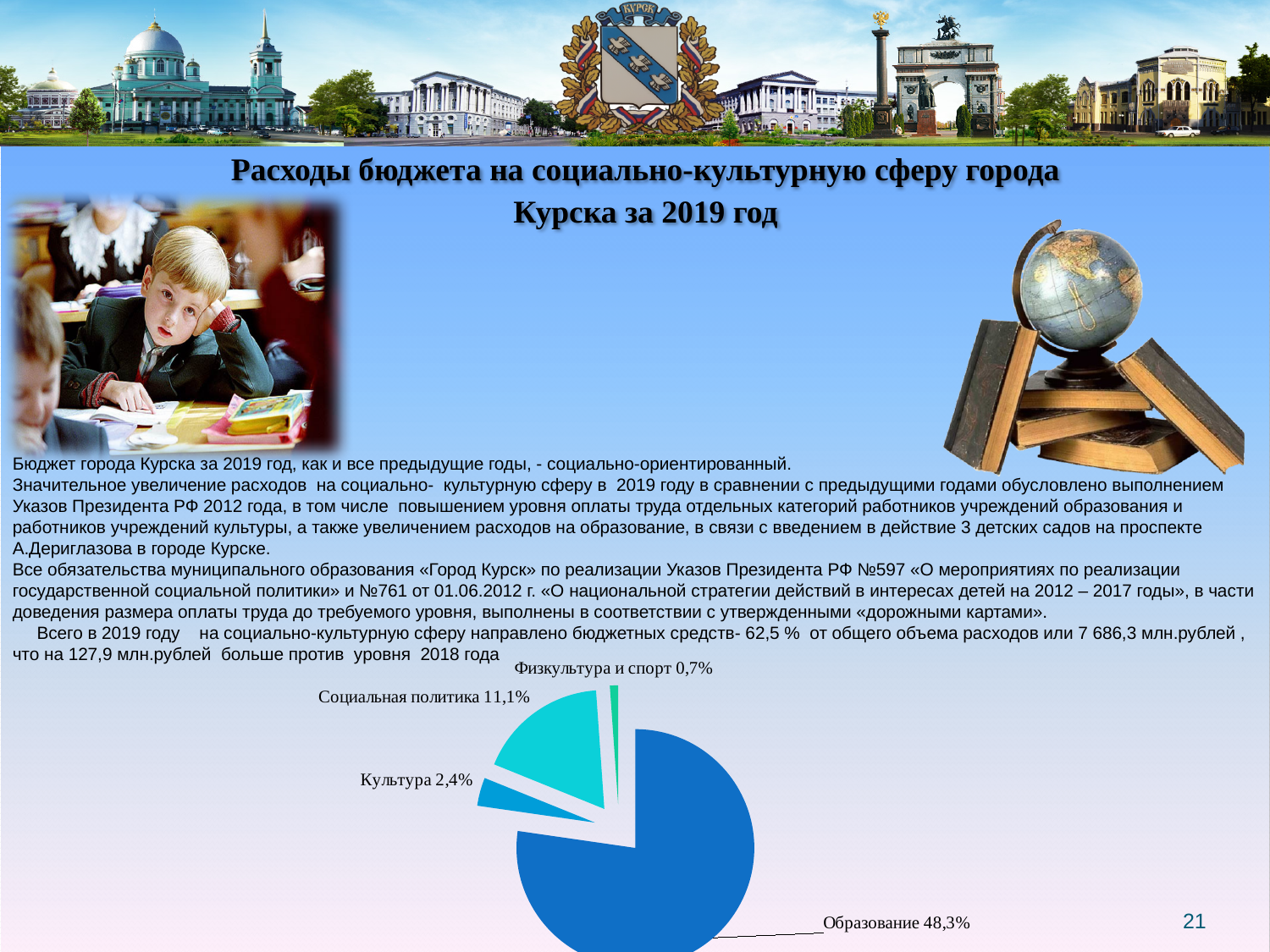
How many slices are labelled in the pie chart? 4 Which category has the largest slice of the pie? Образование What is the difference in percentage points between Образование and Социальная политика? 37,2 What share of the pie does Образование have? 48,3% Which category has the smallest slice of the pie? Физкультура и спорт What share of the pie does Социальная политика have? 11,1% What share of the pie does Физкультура и спорт have? 0,7% Which is larger, the slice for Социальная политика or the slice for Культура? Социальная политика What is the title of the slide containing the pie chart? Расходы бюджета на социально-культурную сферу города Курска за 2019 год What type of chart is shown on the slide? pie chart What share of the pie does Культура have? 2,4% What is the difference in percentage points between Культура and Физкультура и спорт? 1,7